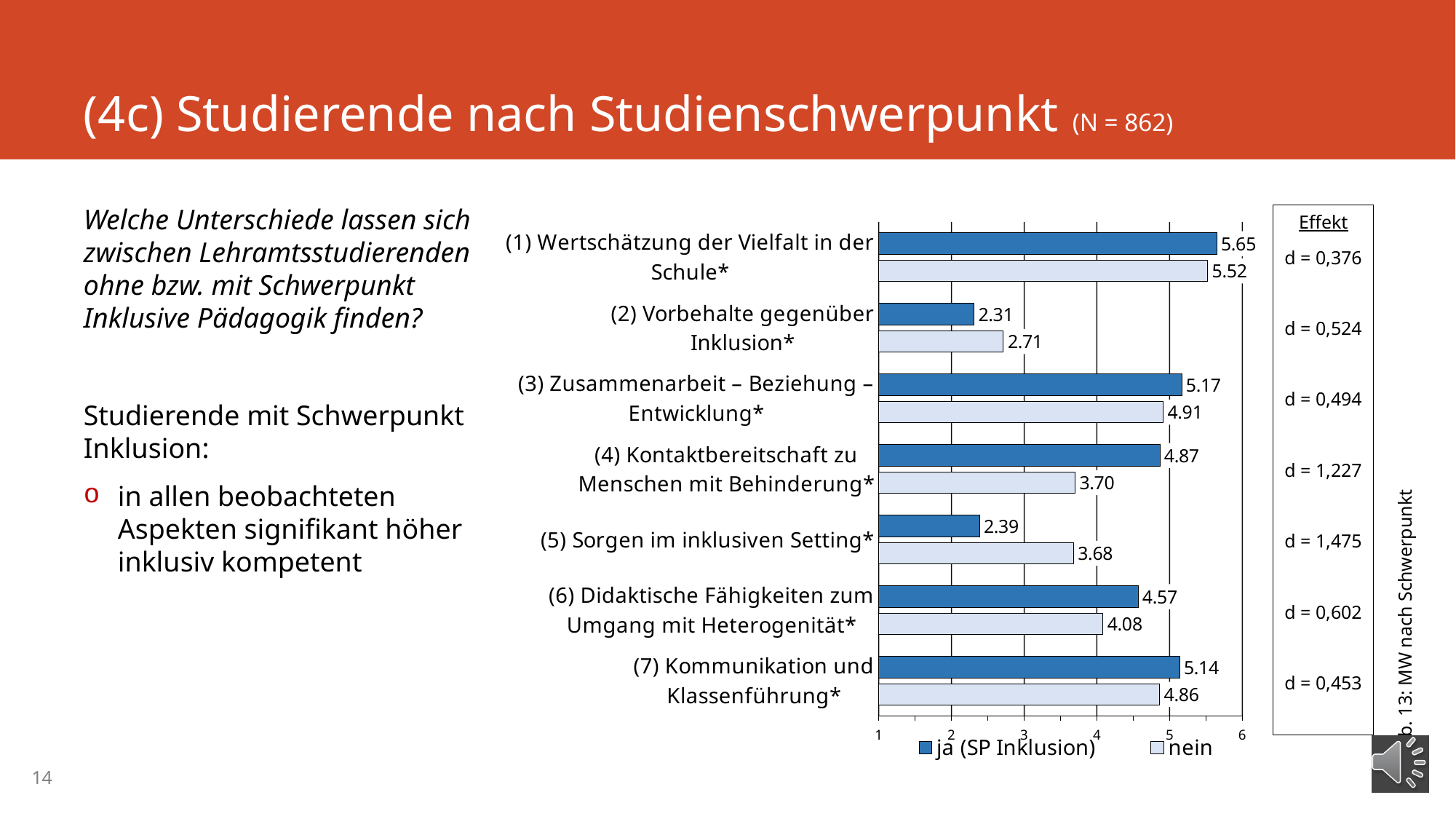
What is the difference between the "ja (SP Inklusion)" and "nein" values for "(5) Sorgen im inklusiven Setting*"? 1.29 What kind of chart is shown on the slide? bar chart What is the value for "ja (SP Inklusion)" for "(5) Sorgen im inklusiven Setting*"? 2.39 How many categories are shown on the chart? 7 For "(2) Vorbehalte gegenüber Inklusion*", which series has the larger value, "ja (SP Inklusion)" or "nein"? nein What are the two legend entries of the chart? ja (SP Inklusion) and nein How many series does the legend list? 2 Is the "nein" value for "(6) Didaktische Fähigkeiten zum Umgang mit Heterogenität*" greater or less than 4? greater What is the value for "nein" for "(4) Kontaktbereitschaft zu Menschen mit Behinderung*"? 3.70 What is the value for "ja (SP Inklusion)" for "(1) Wertschätzung der Vielfalt in der Schule*"? 5.65 Which category has the lowest value for the "ja (SP Inklusion)" series? (2) Vorbehalte gegenüber Inklusion* Which category has the highest value for the "nein" series? (1) Wertschätzung der Vielfalt in der Schule*